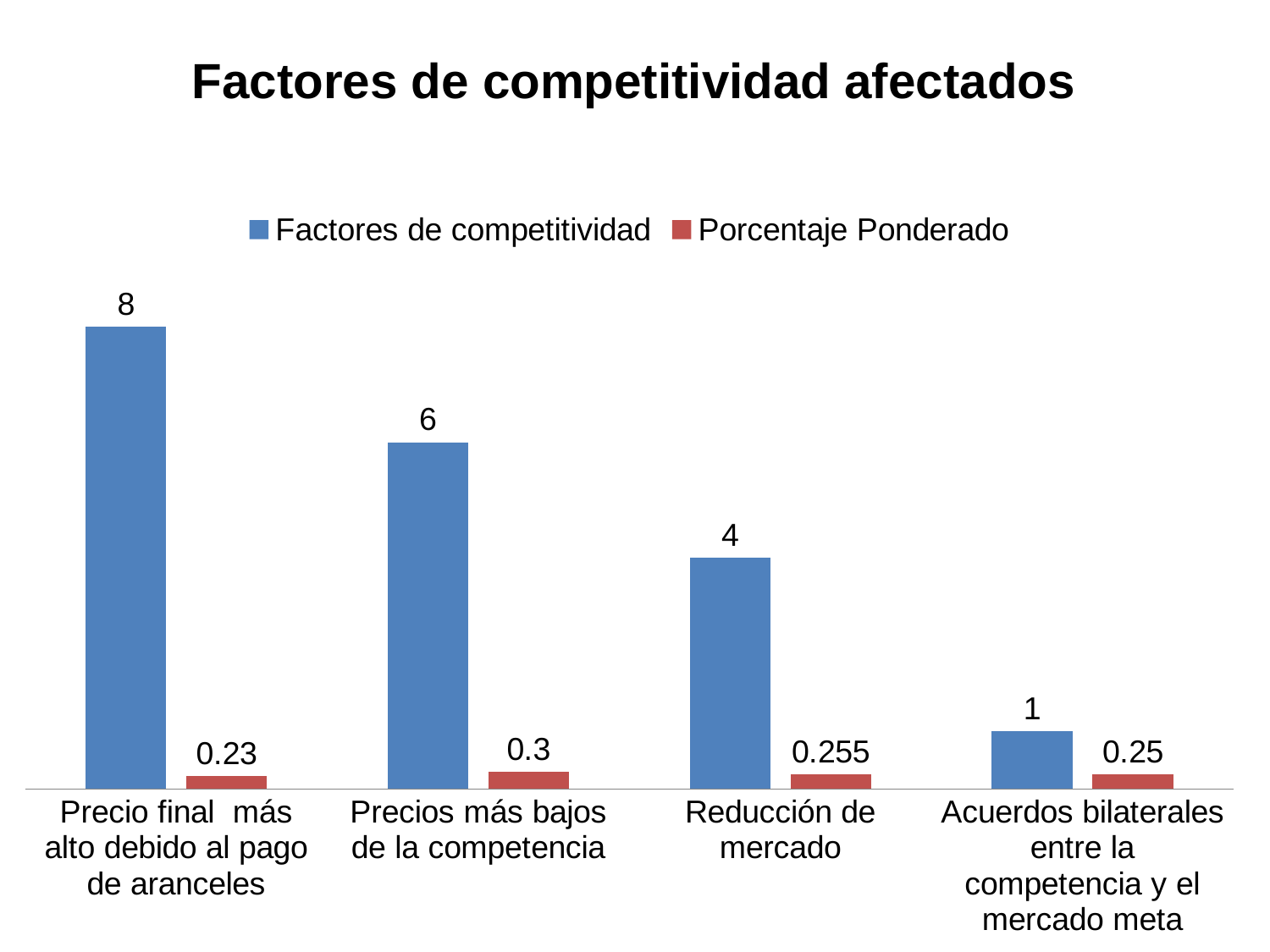
What is the value of "Porcentaje Ponderado" for "Reducción de mercado"? 0.255 Which category has the highest value for "Factores de competitividad"? Precio final más alto debido al pago de aranceles Which is larger: the "Porcentaje Ponderado" value for "Precios más bajos de la competencia" or for "Acuerdos bilaterales entre la competencia y el mercado meta"? Precios más bajos de la competencia How many categories are shown on the x axis? 4 Which category has the lowest value for "Porcentaje Ponderado"? Precio final más alto debido al pago de aranceles How many series does the legend list? 2 What is the difference between the "Factores de competitividad" values for "Precios más bajos de la competencia" and "Reducción de mercado"? 2 What kind of chart is shown on the slide? Bar chart What is the value of "Factores de competitividad" for "Acuerdos bilaterales entre la competencia y el mercado meta"? 1 What is the value of "Factores de competitividad" for "Precio final más alto debido al pago de aranceles"? 8 Do the "Factores de competitividad" values rise or fall from left to right along the x axis? Fall What is the value of "Porcentaje Ponderado" for "Precios más bajos de la competencia"? 0.3